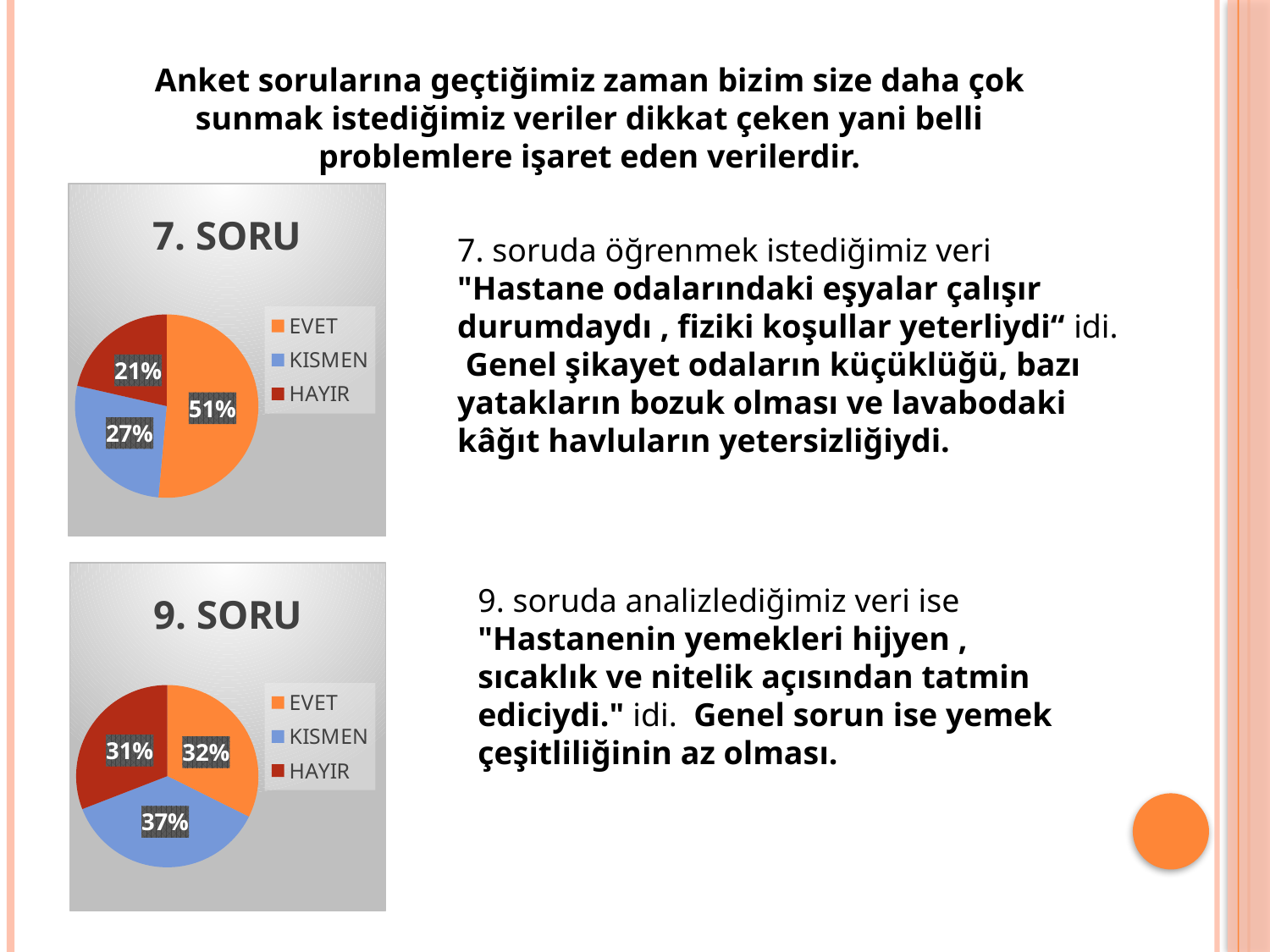
In the "9. SORU" chart, what share does EVET have? 32% In the "7. SORU" chart, what is the difference between EVET and KISMEN? 24% In the "7. SORU" chart, which category has the smallest slice? HAYIR What kind of chart is the "9. SORU" chart? Pie chart In the "9. SORU" chart, which category has the largest slice? KISMEN In the "7. SORU" chart, what is the value for HAYIR? 21% In the "7. SORU" chart, what share does EVET have? 51% In the "9. SORU" chart, what is the difference between KISMEN and HAYIR? 6% In the "7. SORU" chart, which category has the largest slice? EVET In the "9. SORU" chart, what is the value for KISMEN? 37% How many categories does the legend of the "7. SORU" chart list? 3 In the "7. SORU" chart, what is the value for KISMEN? 27%